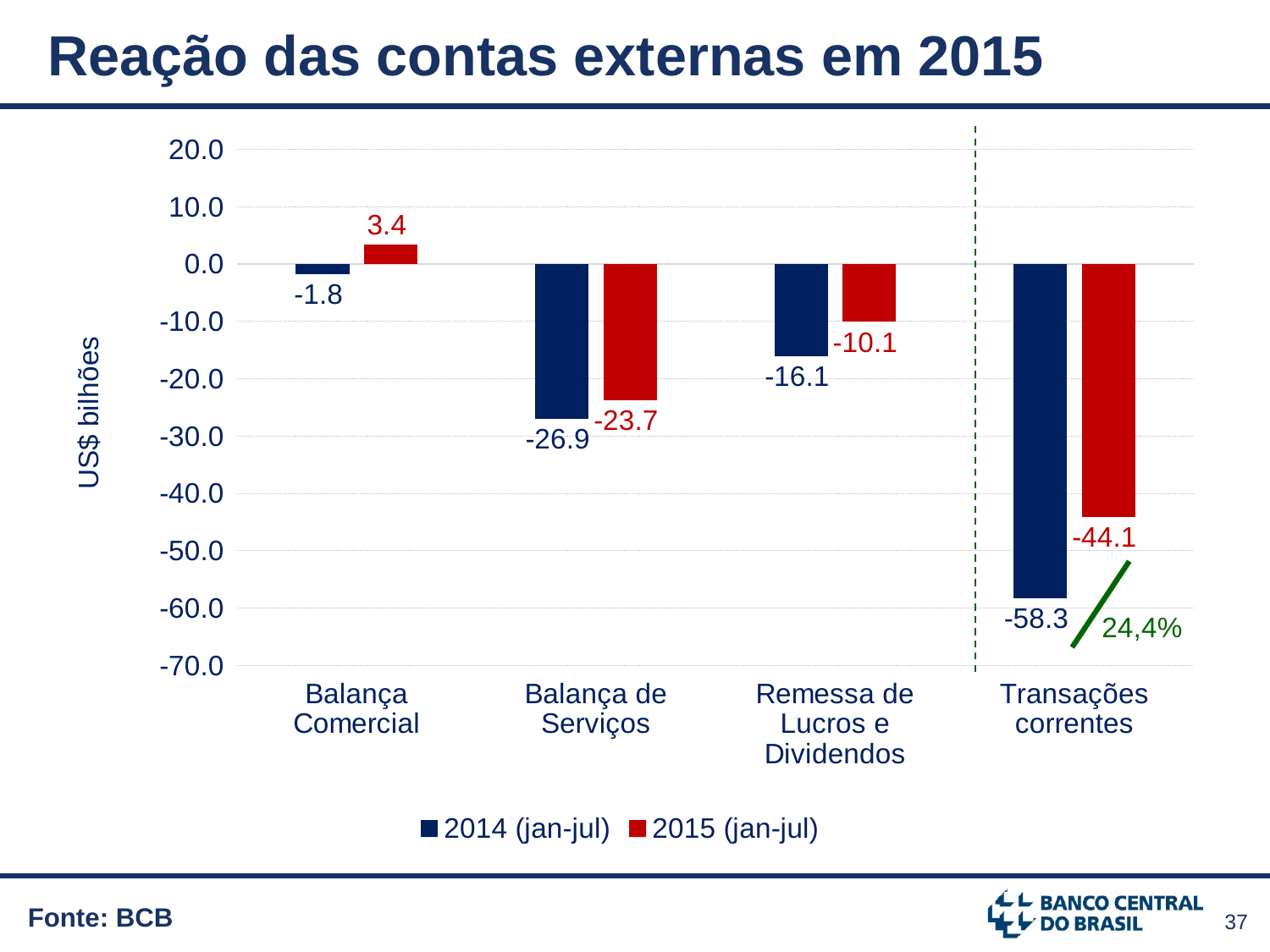
What is the value for Transações correntes in the 2014 (jan-jul) series? -58.3 Which category has the highest value in the 2014 (jan-jul) series? Balança Comercial Which category has the lowest value in the 2015 (jan-jul) series? Transações correntes What is the value for Balança de Serviços in the 2015 (jan-jul) series? -23.7 Which is larger for Remessa de Lucros e Dividendos: the 2014 (jan-jul) value or the 2015 (jan-jul) value? 2015 (jan-jul) What is the value for Balança Comercial in the 2014 (jan-jul) series? -1.8 How many categories are shown on the x axis? 4 What is the label of the vertical axis? US$ bilhões What is the difference between the 2014 (jan-jul) and 2015 (jan-jul) values for Transações correntes? 14.2 What kind of chart is shown on the slide? bar chart How many series does the legend list? 2 What is the value for Balança Comercial in the 2015 (jan-jul) series? 3.4